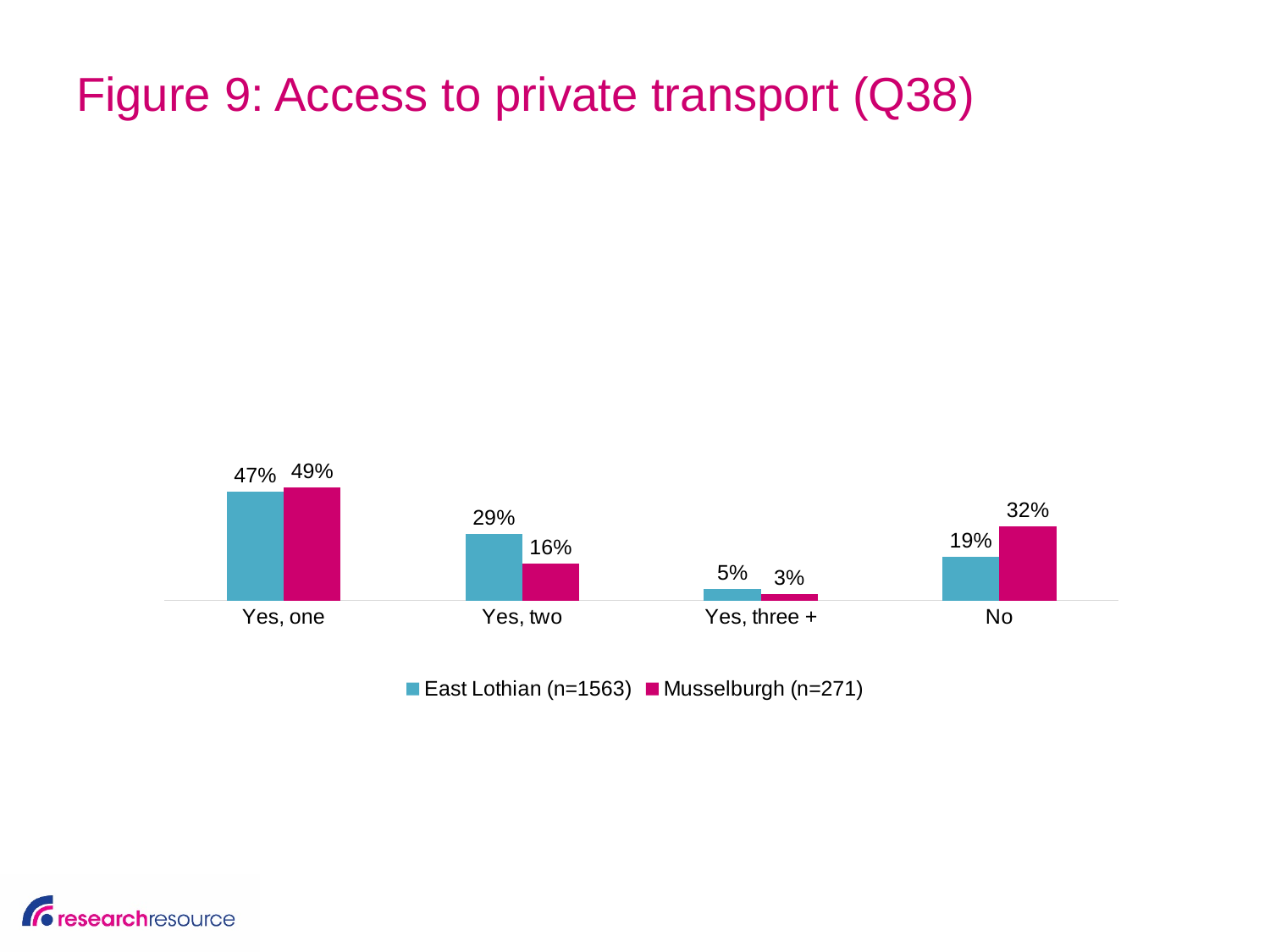
What percentage of East Lothian respondents answered "Yes, one"? 47% What kind of chart is shown on the slide? Bar chart What is the sample size (n) for Musselburgh shown in the legend? 271 How many series does the legend list? 2 How many categories are shown on the x axis? 4 Which is larger for "Yes, three +": East Lothian or Musselburgh? East Lothian What percentage of Musselburgh respondents answered "No"? 32% What is the difference between the Musselburgh and East Lothian values for "No"? 13 percentage points Which category has the highest value for Musselburgh? Yes, one Which category has the lowest value for East Lothian? Yes, three + What is the difference between the East Lothian and Musselburgh values for "Yes, two"? 13 percentage points What is the Musselburgh value for "Yes, two"? 16%